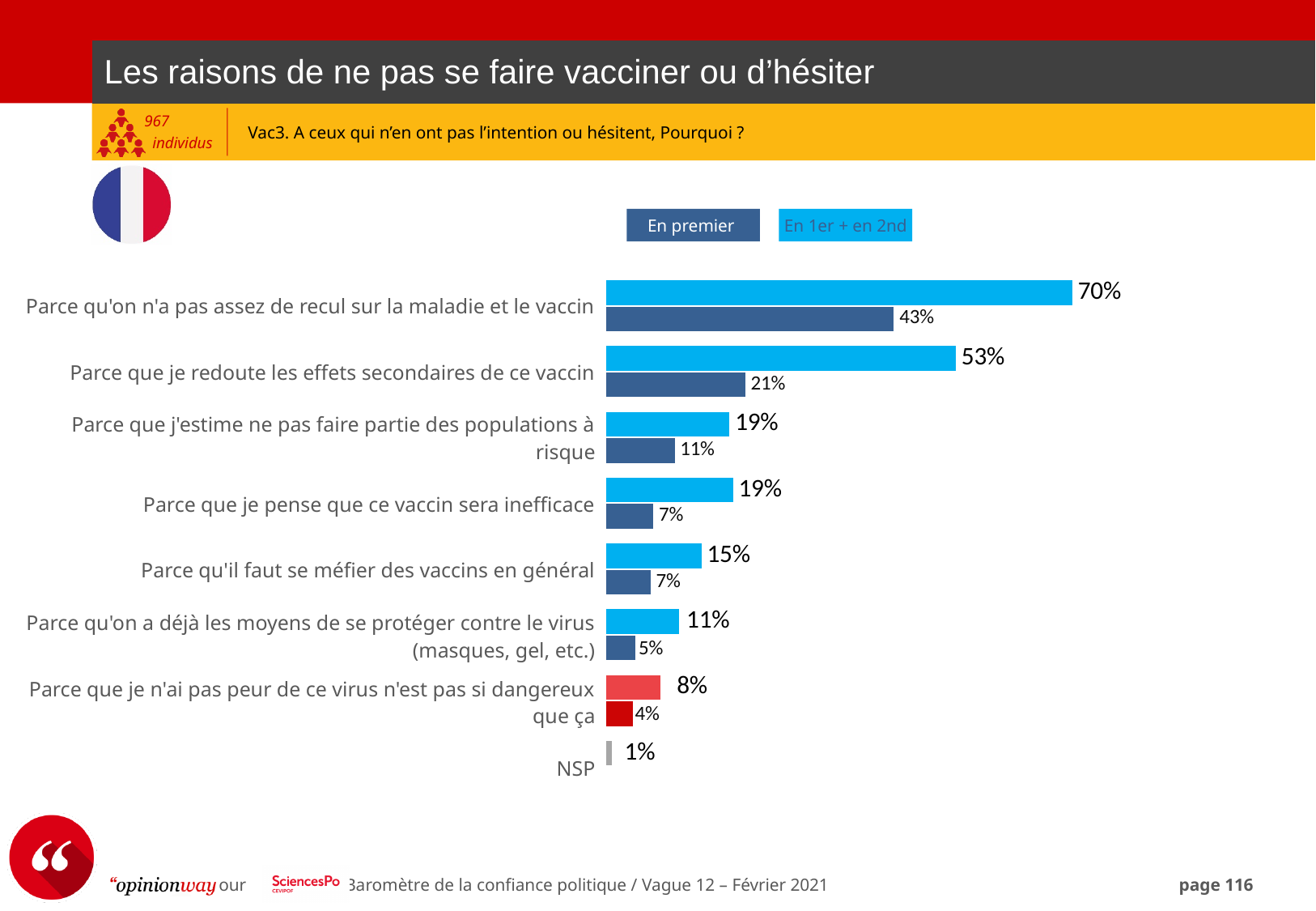
What is the 'En premier' value for 'Parce qu'on a déjà les moyens de se protéger contre le virus (masques, gel, etc.)'? 5% How many series does the legend list? 2 How many categories (reasons, including NSP) are shown on the chart? 8 Which category has the lowest value shown on the chart? NSP Which reason has the highest 'En 1er + en 2nd' value? Parce qu'on n'a pas assez de recul sur la maladie et le vaccin What is the 'En 1er + en 2nd' value for 'Parce qu'on n'a pas assez de recul sur la maladie et le vaccin'? 70% What is the 'En premier' value for 'Parce que je redoute les effets secondaires de ce vaccin'? 21% What is the difference between the 'En 1er + en 2nd' values for 'Parce que je redoute les effets secondaires de ce vaccin' and 'Parce qu'il faut se méfier des vaccins en général'? 38% Which is larger: the 'En premier' value for 'Parce que je pense que ce vaccin sera inefficace' or for 'Parce que j'estime ne pas faire partie des populations à risque'? Parce que j'estime ne pas faire partie des populations à risque What kind of chart is shown on the slide? Bar chart What is the difference between the 'En 1er + en 2nd' and 'En premier' values for 'Parce qu'on n'a pas assez de recul sur la maladie et le vaccin'? 27% What are the two legend entries of the chart? En premier; En 1er + en 2nd